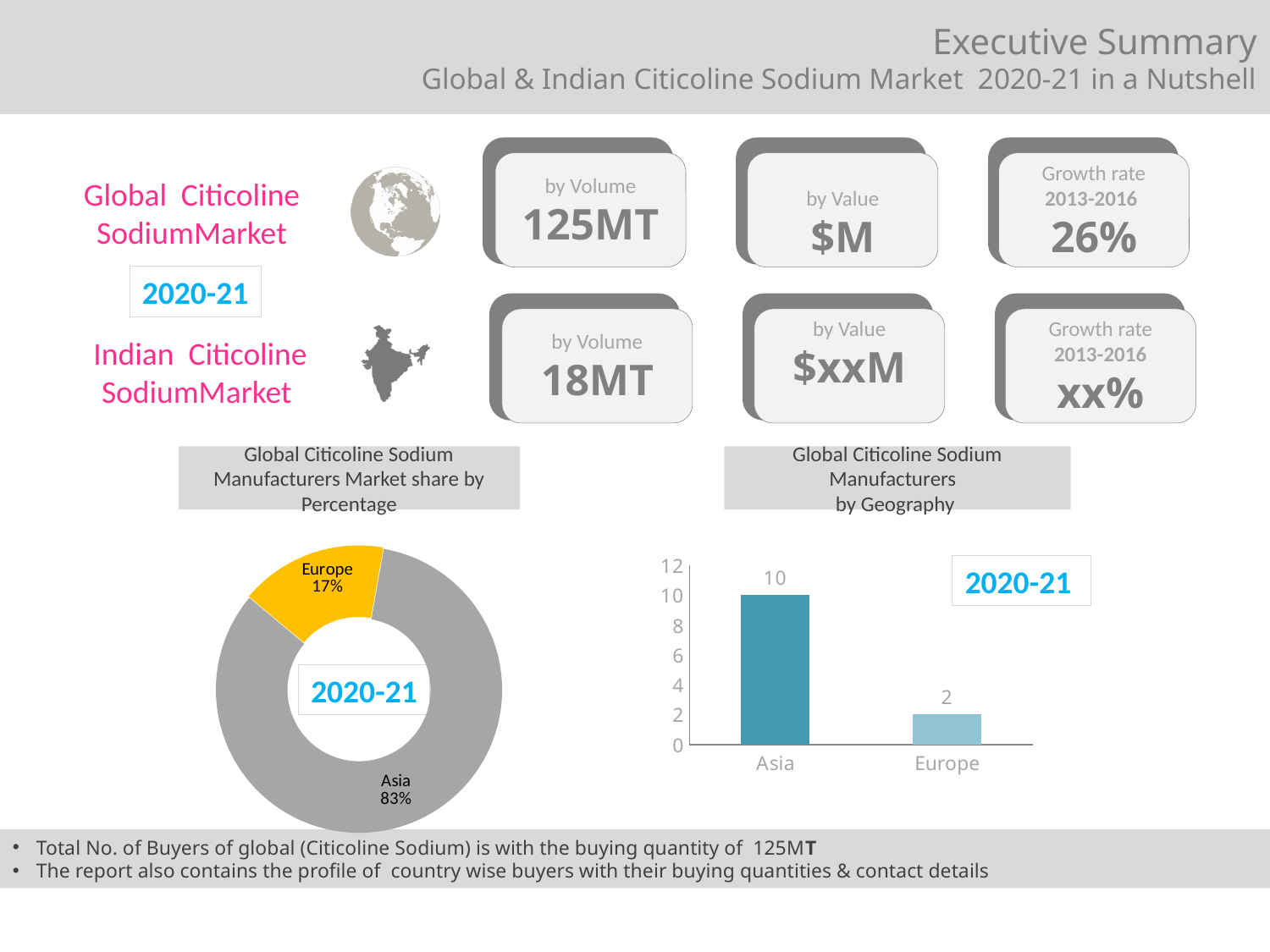
In the 'Global Citicoline Sodium Manufacturers by Geography' chart, what is the value for Asia? 10 In the 'Global Citicoline Sodium Manufacturers by Geography' chart, what is the highest value shown on the y axis? 12 What kind of chart is the 'Global Citicoline Sodium Manufacturers Market share by Percentage' chart? Pie (donut) chart In the 'Global Citicoline Sodium Manufacturers Market share by Percentage' chart, which region has the largest share? Asia In the 'Global Citicoline Sodium Manufacturers by Geography' chart, how many categories are shown on the x axis? 2 What kind of chart is the 'Global Citicoline Sodium Manufacturers by Geography' chart? Bar chart In the 'Global Citicoline Sodium Manufacturers by Geography' chart, what is the difference between the values for Asia and Europe? 8 In the 'Global Citicoline Sodium Manufacturers by Geography' chart, which region has the lowest value? Europe In the 'Global Citicoline Sodium Manufacturers Market share by Percentage' chart, what is the difference in percentage points between Asia's and Europe's shares? 66 In the 'Global Citicoline Sodium Manufacturers by Geography' chart, what is the value for Europe? 2 In the 'Global Citicoline Sodium Manufacturers Market share by Percentage' chart, what share does Asia hold? 83% In the 'Global Citicoline Sodium Manufacturers Market share by Percentage' chart, what share does Europe hold? 17%